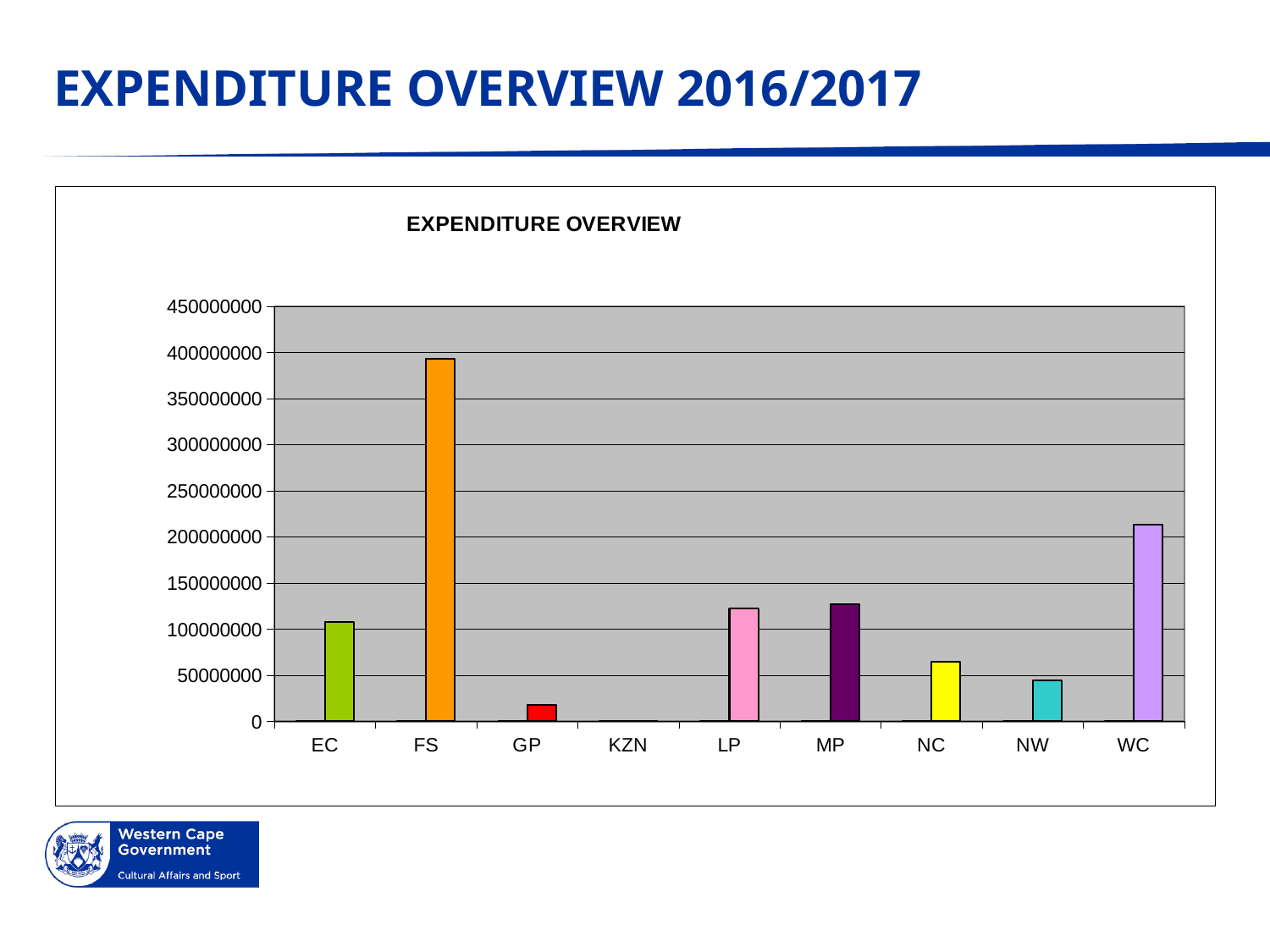
What kind of chart is shown on the slide? bar chart Which has the larger expenditure, FS or WC? FS Which has the larger expenditure, EC or NC? EC Is the value for FS greater or less than 350000000? greater Is the value for GP greater or less than 50000000? less Which category has the lowest expenditure? KZN What colour is the bar for FS? orange What is the title of the chart? EXPENDITURE OVERVIEW Which has the larger expenditure, WC or MP? WC Which category has the highest expenditure? FS Is the value for WC greater or less than 200000000? greater How many categories are shown on the x axis of the chart? 9